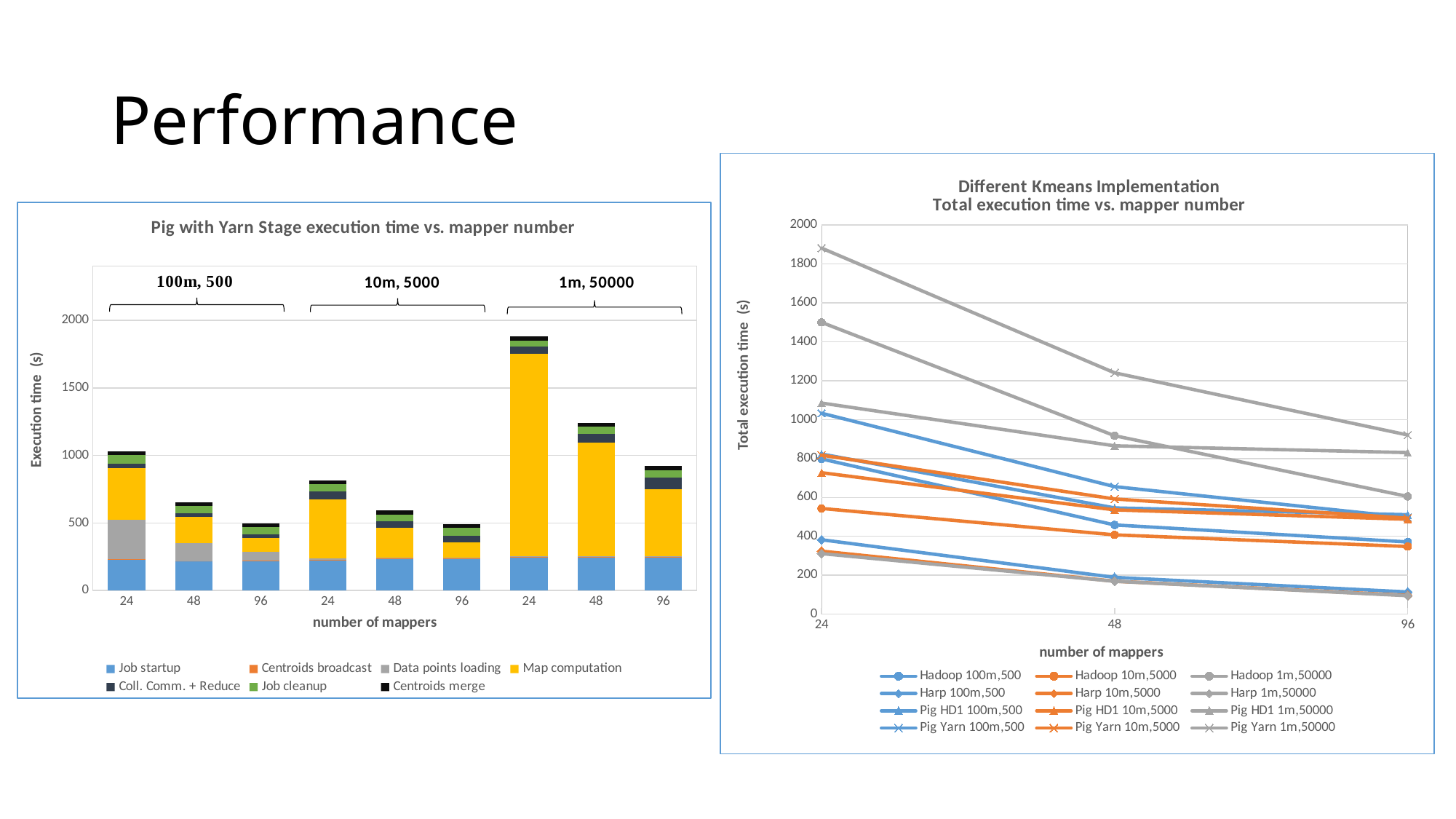
In the left chart, how many bars are plotted? 9 In the left chart, within the 1m, 50000 group, does total execution time rise or fall as the number of mappers increases? fall In the left chart, is the total execution time for 100m, 500 with 48 mappers greater or less than 1000? less What kind of chart is the right chart, 'Different Kmeans Implementation Total execution time vs. mapper number'? line chart In the right chart, which series has the highest total execution time at 24 mappers? Pig Yarn 1m,50000 In the left chart, which bar has the highest total execution time? 1m, 50000 with 24 mappers In the right chart, how many mapper-number points are on the x axis? 3 In the left chart, how many series does the legend list? 7 What kind of chart is the left chart, 'Pig with Yarn Stage execution time vs. mapper number'? stacked bar chart In the right chart, how many series does the legend list? 12 In the left chart, is the total execution time for 1m, 50000 with 24 mappers greater or less than 1500? greater In the right chart, is the value for Pig Yarn 1m,50000 at 24 mappers greater or less than 1800? greater